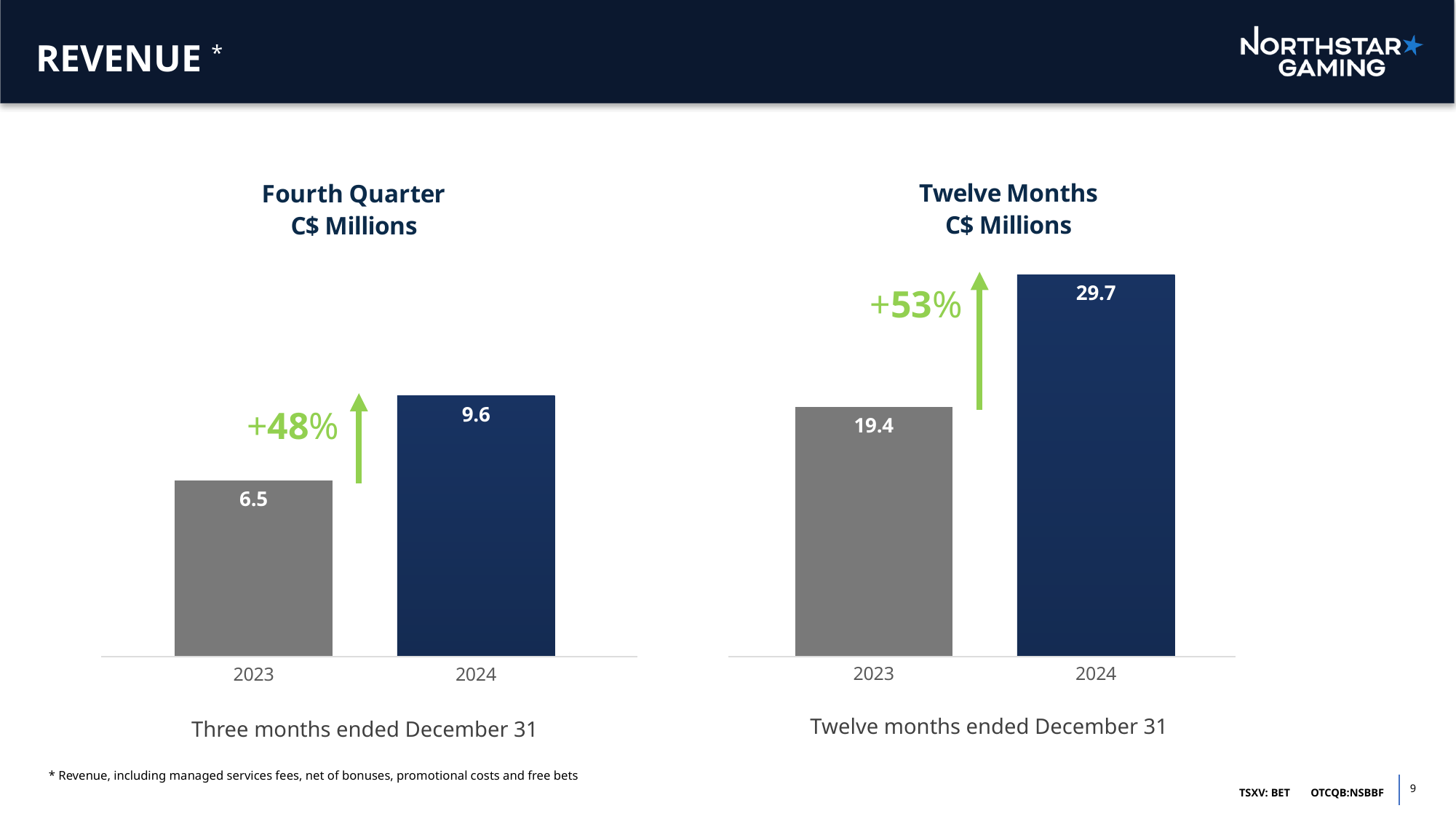
In the Twelve Months chart, is the 2024 value larger or smaller than the 2023 value? larger In the Fourth Quarter chart, which year has the higher revenue? 2024 In the Twelve Months chart, what is the difference between the 2024 and 2023 values? 10.3 How many bars are shown in the Fourth Quarter chart? 2 In the Twelve Months chart, which year has the lower revenue? 2023 What percentage increase is labelled on the Fourth Quarter chart? +48% In the Twelve Months chart, what is the revenue value for 2024? 29.7 In the Fourth Quarter chart, what is the revenue value for 2024? 9.6 In the Fourth Quarter chart, what is the difference between the 2024 and 2023 values? 3.1 In the Twelve Months chart, what is the revenue value for 2023? 19.4 In the Fourth Quarter chart, what is the revenue value for 2023? 6.5 What type of chart is the Twelve Months chart? bar chart